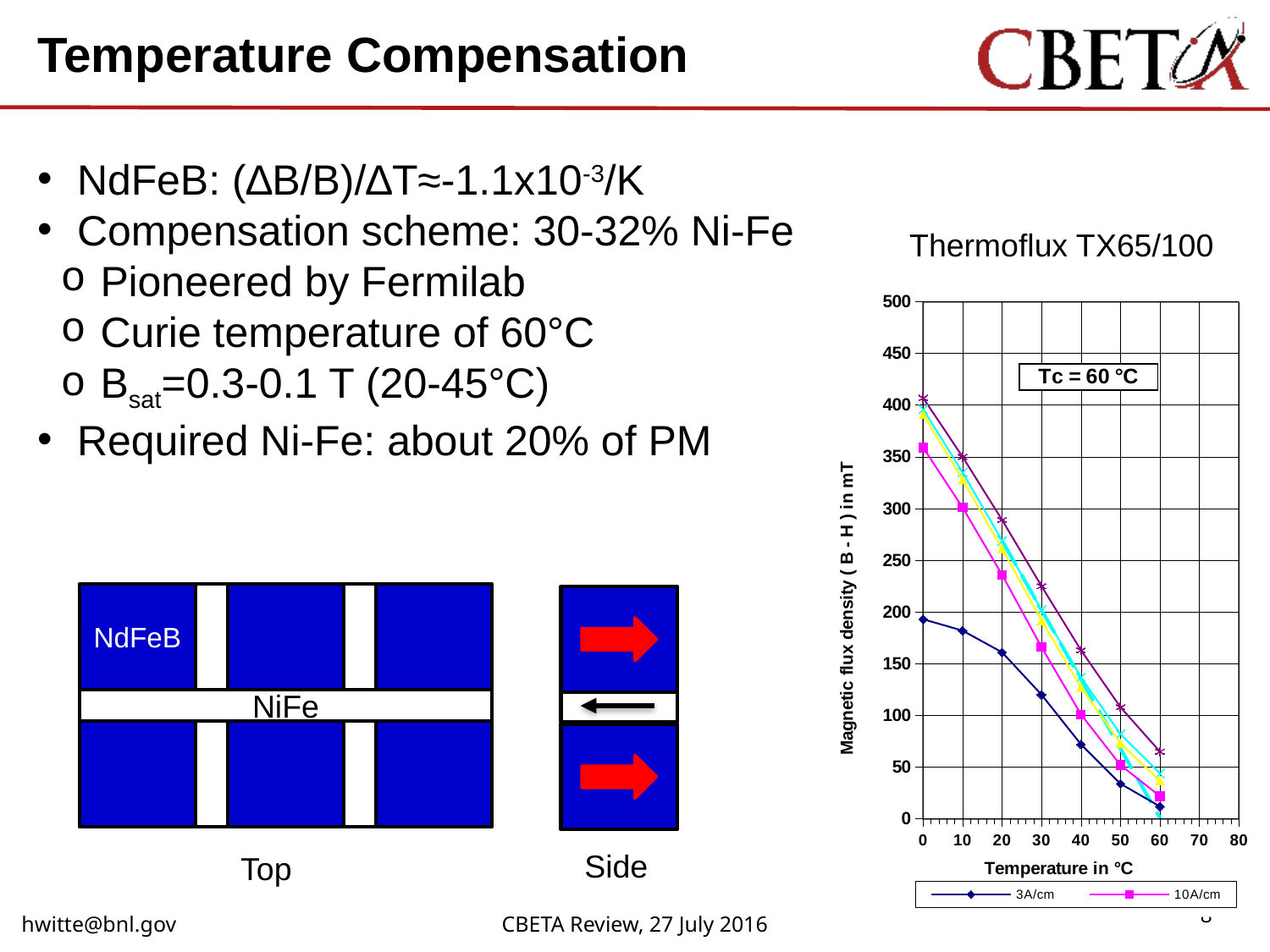
What is the highest value shown on the y axis of the chart? 500 What is the title of the chart on the slide? Thermoflux TX65/100 What is the highest temperature shown on the x axis of the chart? 80 Is the value of the 10A/cm series at 30 °C greater or less than 150? greater Is the value of the 10A/cm series at 0 °C greater or less than 300? greater What is the label of the x axis of the chart? Temperature in °C Is the value of the 3A/cm series at 60 °C greater or less than 50? less Do the plotted values rise or fall as temperature increases along the x axis? fall What Curie temperature is stated in the text box inside the chart? Tc = 60 °C What type of chart is shown on the slide? line chart At 0 °C, which series has the larger value, 3A/cm or 10A/cm? 10A/cm